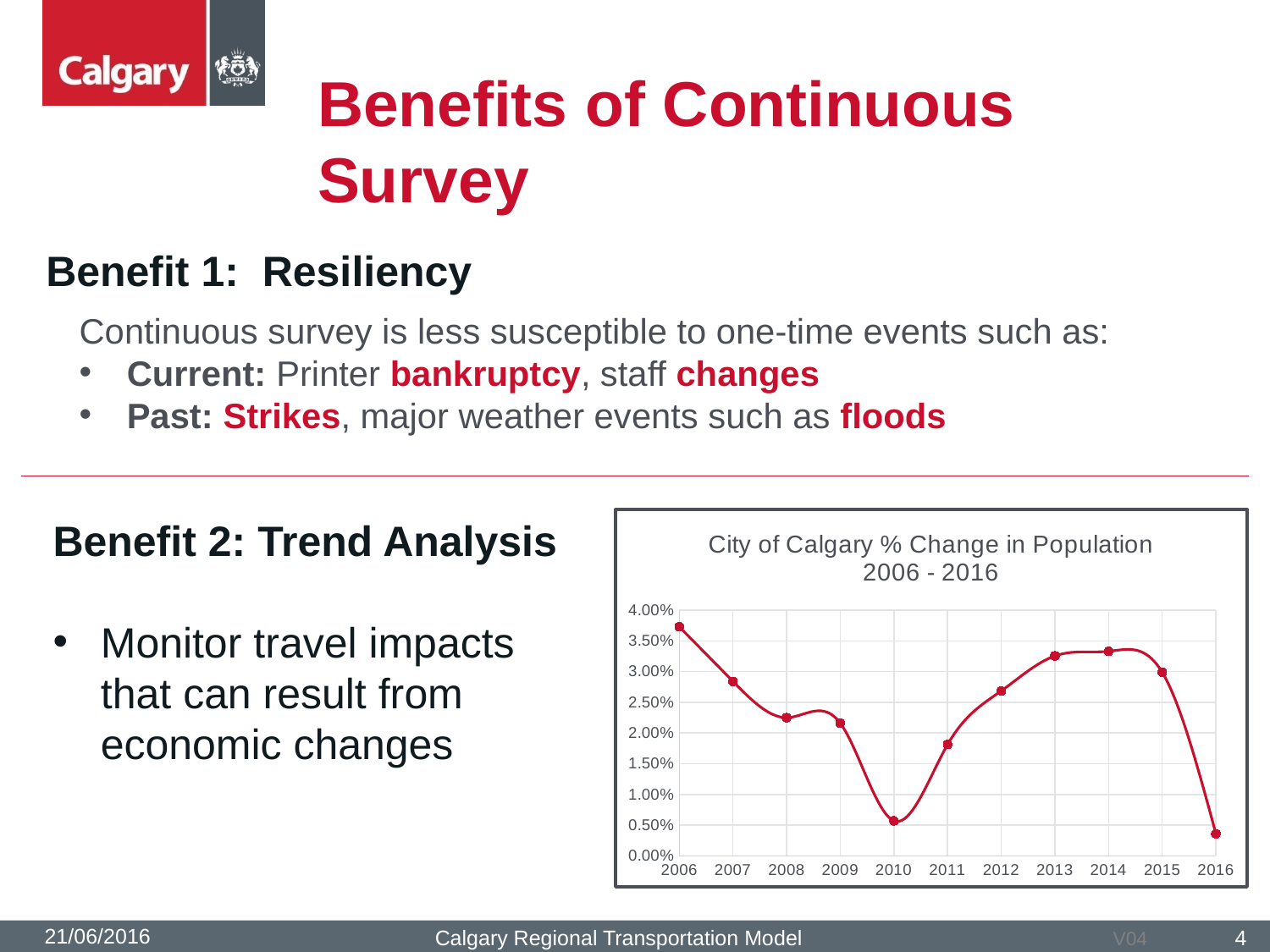
Is the value for 2013 greater or less than 3.00%? greater Is the value for 2006 greater or less than 3.50%? greater Does the % change in population rise or fall from 2006 to 2010? fall Which year has the lowest % change in population? 2016 What is the title of the chart? City of Calgary % Change in Population 2006 - 2016 Does the % change in population rise or fall from 2010 to 2014? rise Is the value for 2010 greater or less than 1.00%? less What kind of chart is shown on the slide? line chart How many years are plotted on the x axis of the chart? 11 Which year has the highest % change in population? 2006 Which year has the larger % change in population, 2008 or 2012? 2012